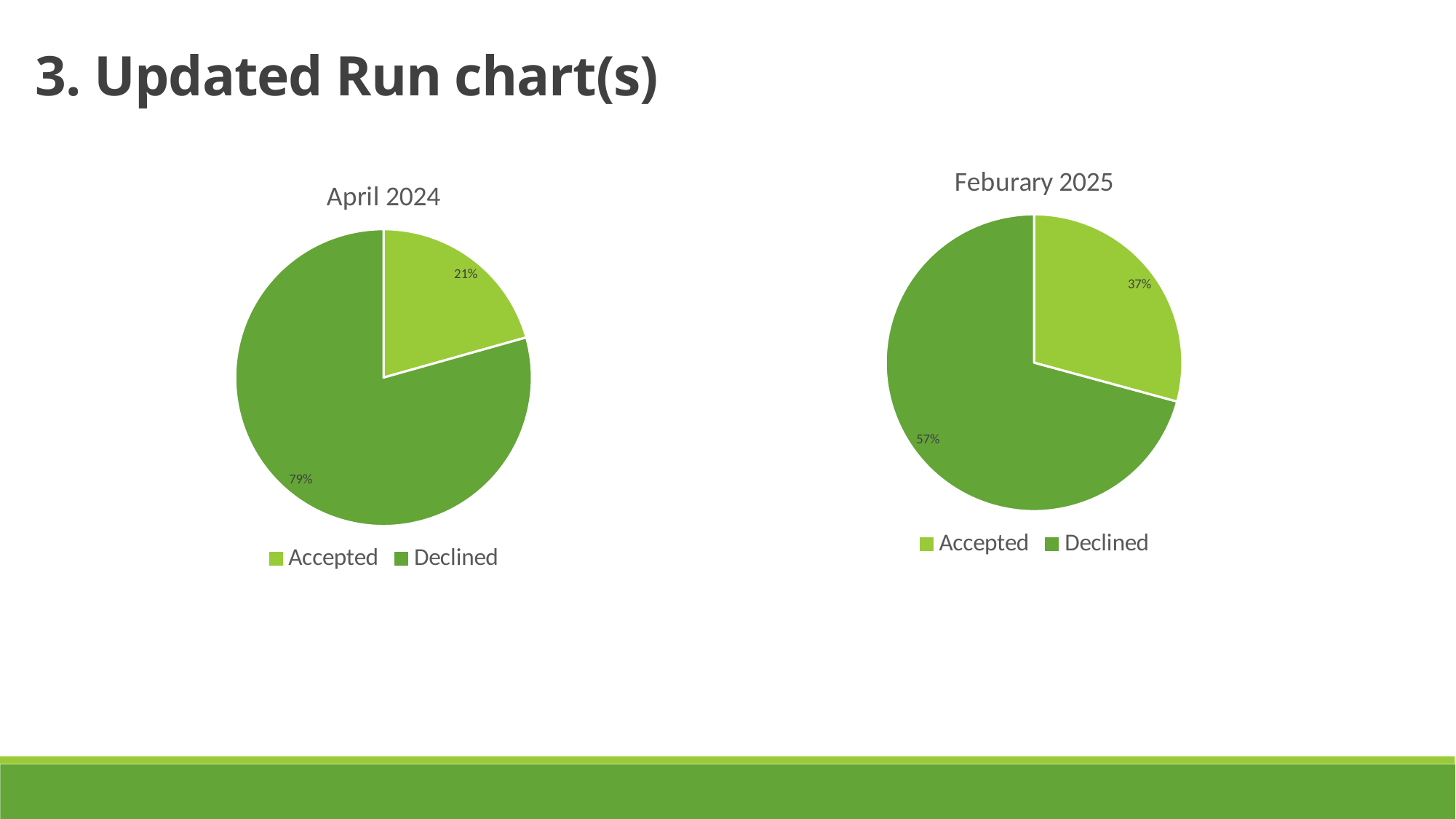
How many slices does the Feburary 2025 pie chart have? 2 How many entries does the legend of the April 2024 chart list? 2 In the Feburary 2025 chart, what percentage is shown for Accepted? 37% In the April 2024 chart, what percentage is shown for Declined? 79% In the April 2024 chart, what is the difference in percentage points between Declined and Accepted? 58 In the Feburary 2025 chart, what percentage is shown for Declined? 57% In the April 2024 chart, what percentage is shown for Accepted? 21% Is the Accepted share larger in the April 2024 chart or the Feburary 2025 chart? Feburary 2025 What type of chart is the April 2024 chart? Pie chart In the Feburary 2025 chart, which category has the smallest slice? Accepted In the Feburary 2025 chart, what is the difference in percentage points between Declined and Accepted? 20 In the April 2024 chart, which category has the largest slice? Declined